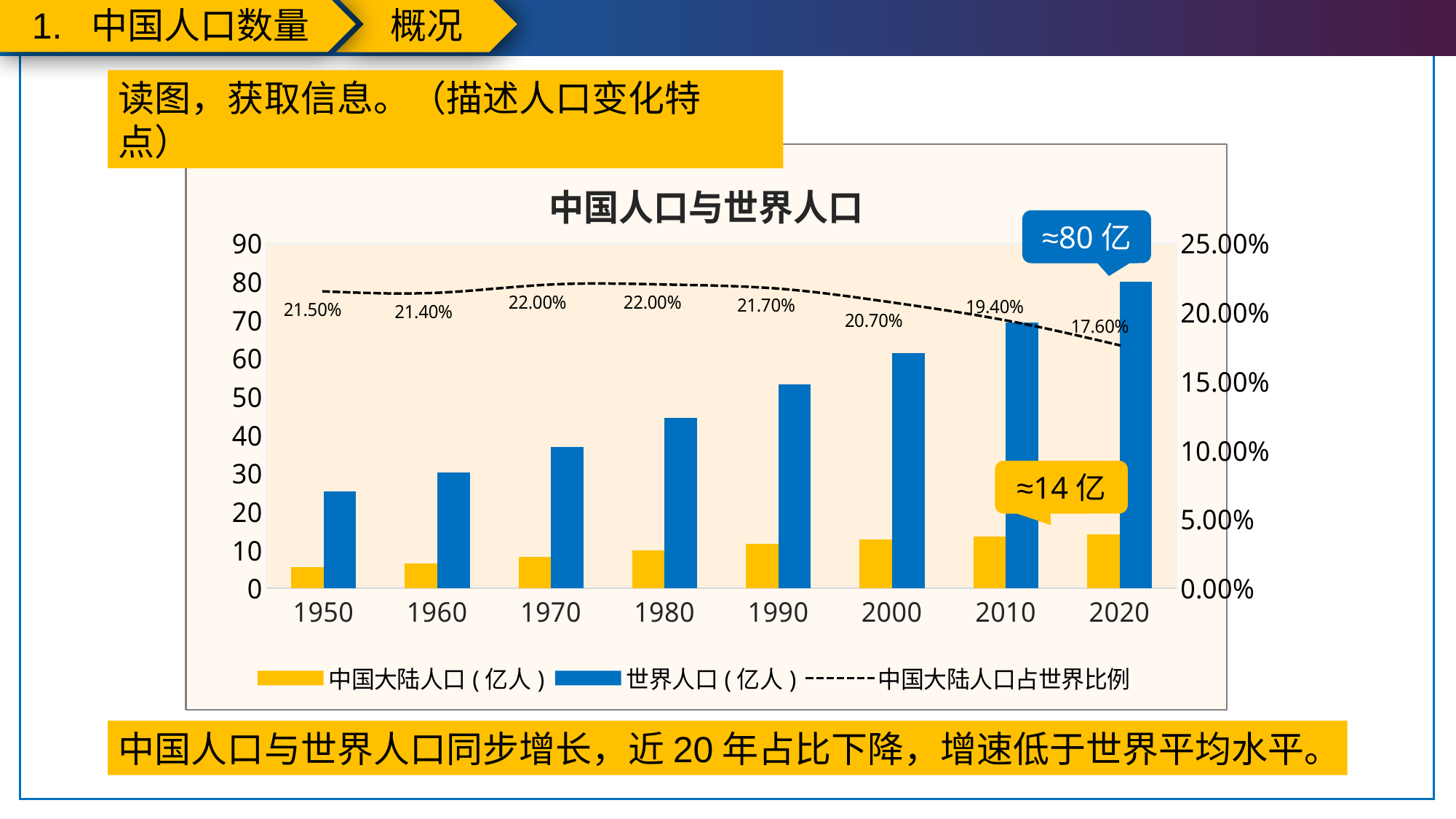
How many series does the legend list? 3 Does 中国大陆人口占世界比例 rise or fall from 1990 to 2020? fall Which is larger, the 世界人口 bar for 1950 or for 2020? 2020 In which year is 中国大陆人口占世界比例 the lowest? 2020 What is the value of 中国大陆人口占世界比例 in 2020? 17.60% Is the 中国大陆人口 value for 2020 greater or less than 20? less What is the value of 中国大陆人口占世界比例 in 1950? 21.50% What kind of chart is this? bar chart with a line By how much did 中国大陆人口占世界比例 fall from 2010 to 2020? 1.80% How many years are shown on the x axis? 8 What is the value of 中国大陆人口占世界比例 in 2000? 20.70% Is the 世界人口 value for 1950 greater or less than 20? greater